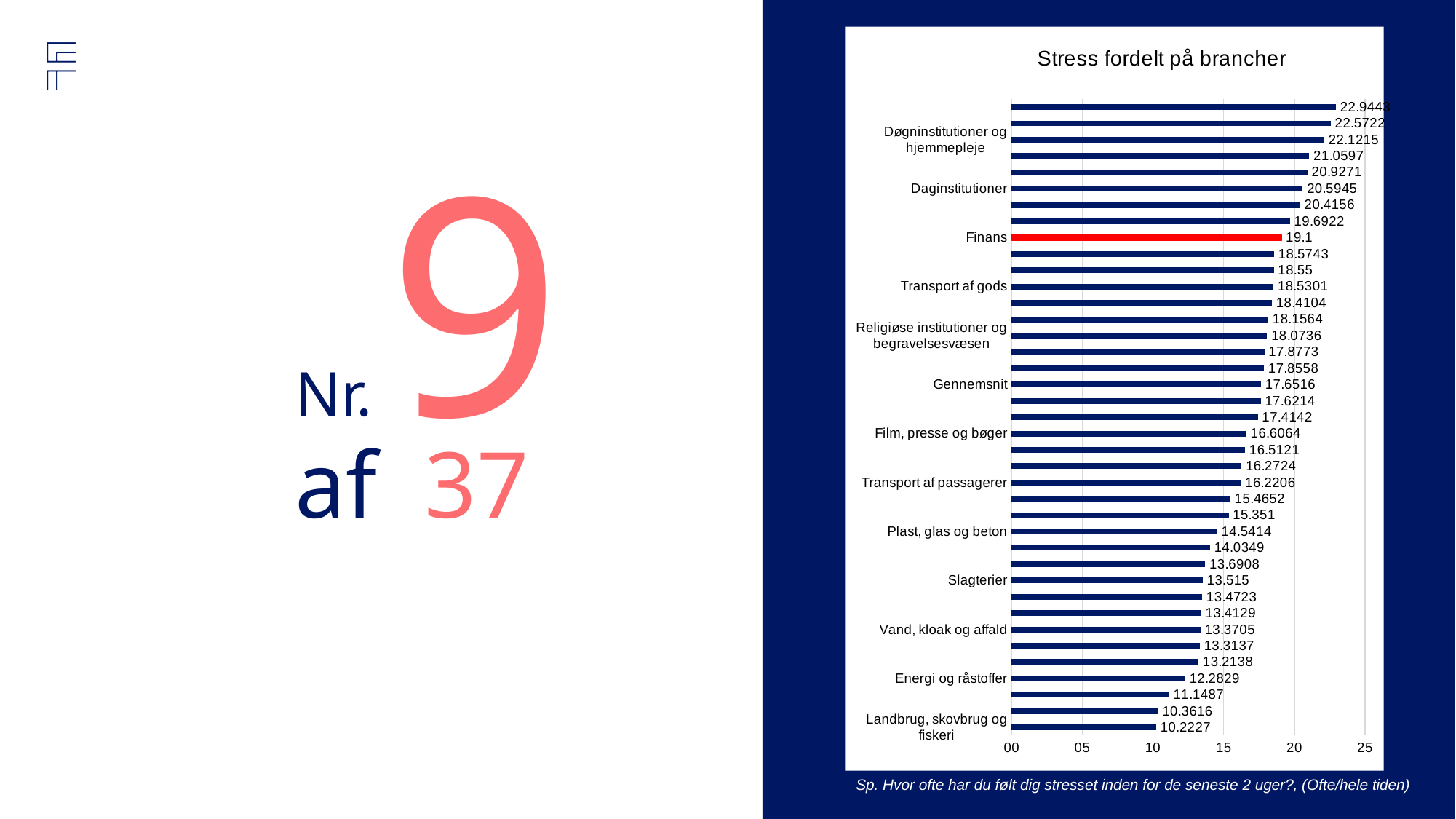
What is the value for Daginstitutioner? 20.5945 Which category's bar is highlighted in red? Finans What is the difference between the value for Finans and the value for Gennemsnit? 1.4484 What kind of chart is shown on the slide? bar chart What is the difference between the value for Daginstitutioner and the value for Finans? 1.4945 What is the value for Gennemsnit? 17.6516 What is the value for Slagterier? 13.515 What is the value for Landbrug, skovbrug og fiskeri? 10.2227 What is the value for Finans in the chart? 19.1 Is the value for Energi og råstoffer greater or less than 15? less Which is larger, the value for Finans or the value for Gennemsnit? Finans Is the value for Transport af gods greater or less than 15? greater